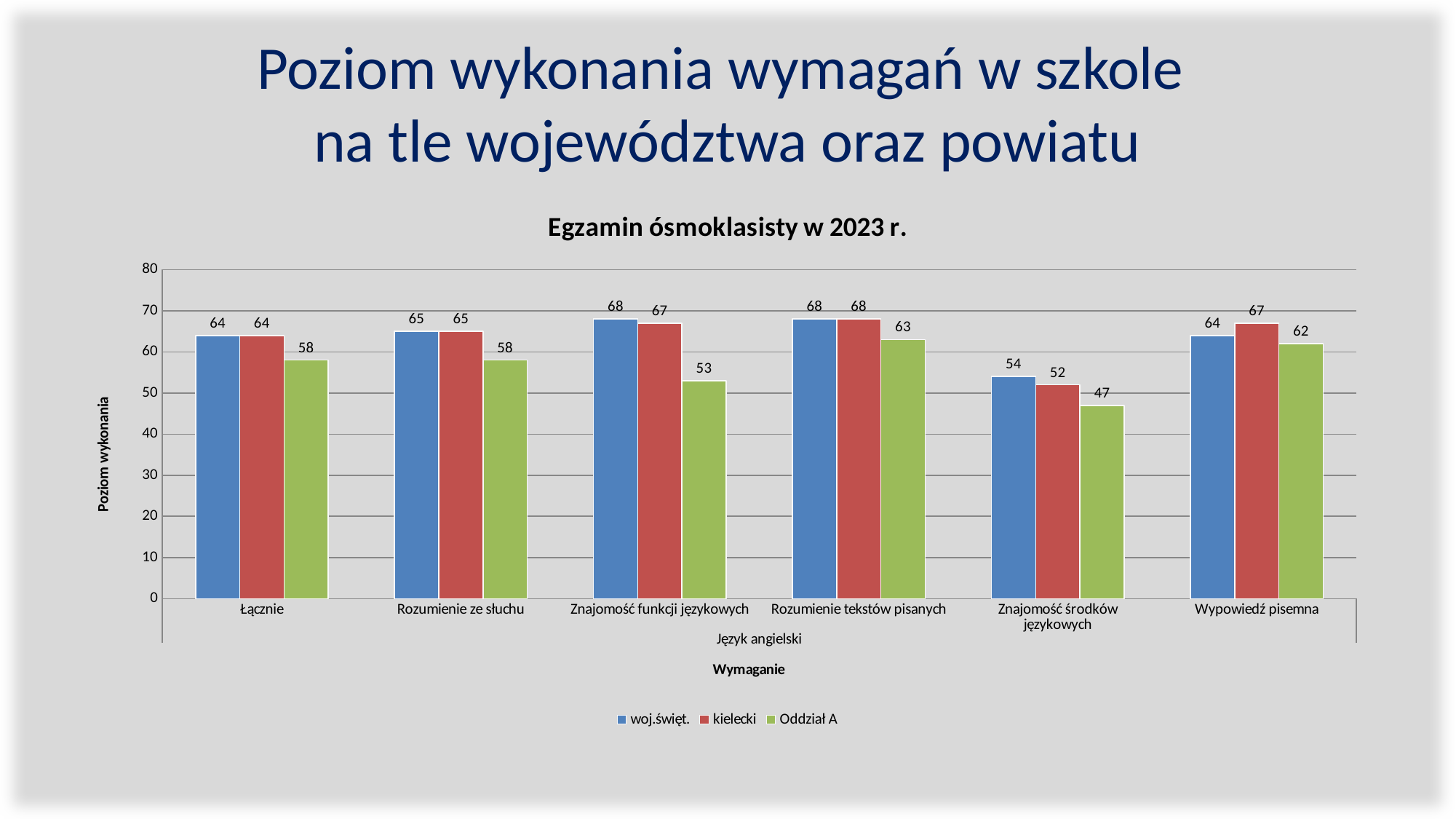
Which category has the lowest value for Oddział A? Znajomość środków językowych How many series does the legend list? 3 What is the value for Oddział A in the Łącznie category? 58 What is the label of the vertical axis? Poziom wykonania What kind of chart is shown on the slide? bar chart How many categories are shown on the x axis? 6 What is the difference between the woj.święt. and Oddział A values in the Znajomość funkcji językowych category? 15 What is the value for kielecki in the Znajomość funkcji językowych category? 67 What is the value for woj.święt. in the Znajomość środków językowych category? 54 What is the title of the chart? Egzamin ósmoklasisty w 2023 r. In the Wypowiedź pisemna category, which is larger: the value for kielecki or the value for Oddział A? kielecki Which category has the highest value for Oddział A? Rozumienie tekstów pisanych